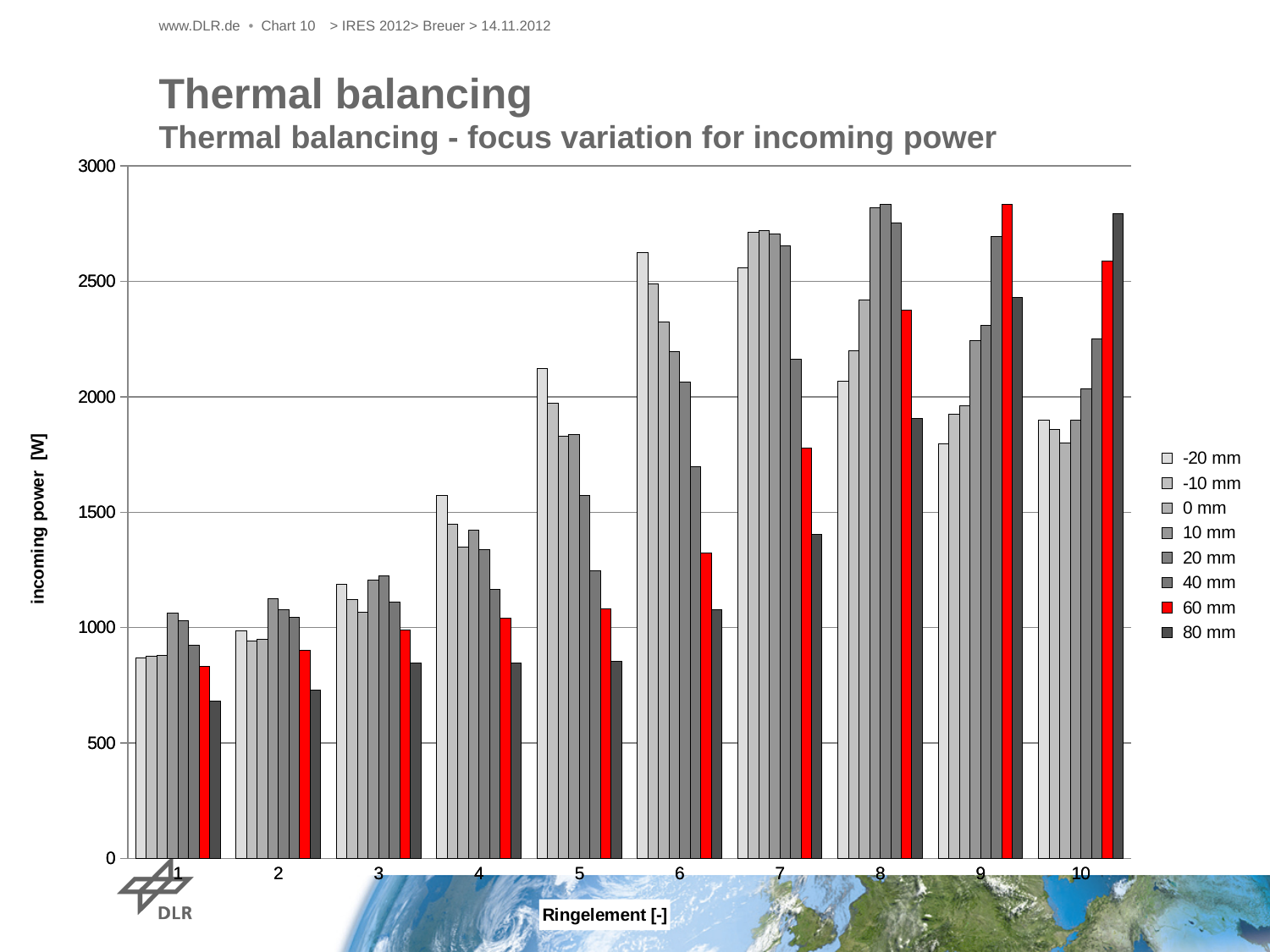
Is the value for 80 mm at Ringelement 1 greater or less than 1000? less Is the value for 60 mm at Ringelement 6 greater or less than 1500? less At which Ringelement is the 60 mm bar highest? 9 How many series does the legend list? 8 How many Ringelement categories are shown on the x axis? 10 At Ringelement 8, which is larger: the 40 mm bar or the 80 mm bar? 40 mm Which series is drawn in red? 60 mm Is the value for 60 mm at Ringelement 9 greater or less than 2500? greater What kind of chart is shown on the slide? bar chart Does the 60 mm series rise or fall from Ringelement 1 to Ringelement 9? rise What is the label of the y axis? incoming power [W]